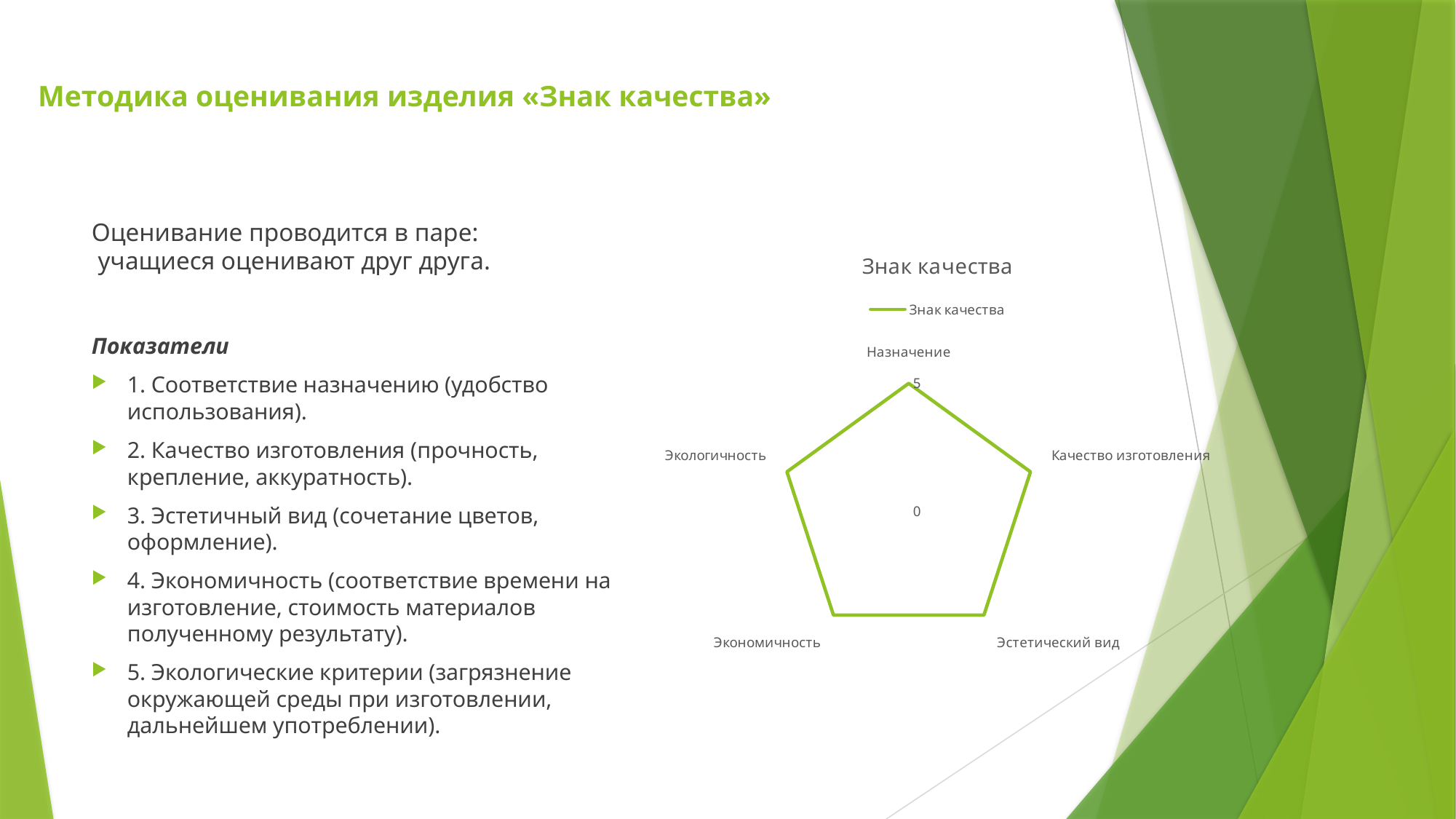
What is the value for Назначение? 5 How many series does the legend list? 1 How many categories (axes) does the radar chart have? 5 What is the title of the chart? Знак качества What kind of chart is shown on the slide? radar chart What is the maximum value shown on the chart's axis scale? 5 Is the value for Экологичность greater or less than 0? greater Is the value for Экономичность greater or less than 0? greater What is the name of the series in the legend? Знак качества